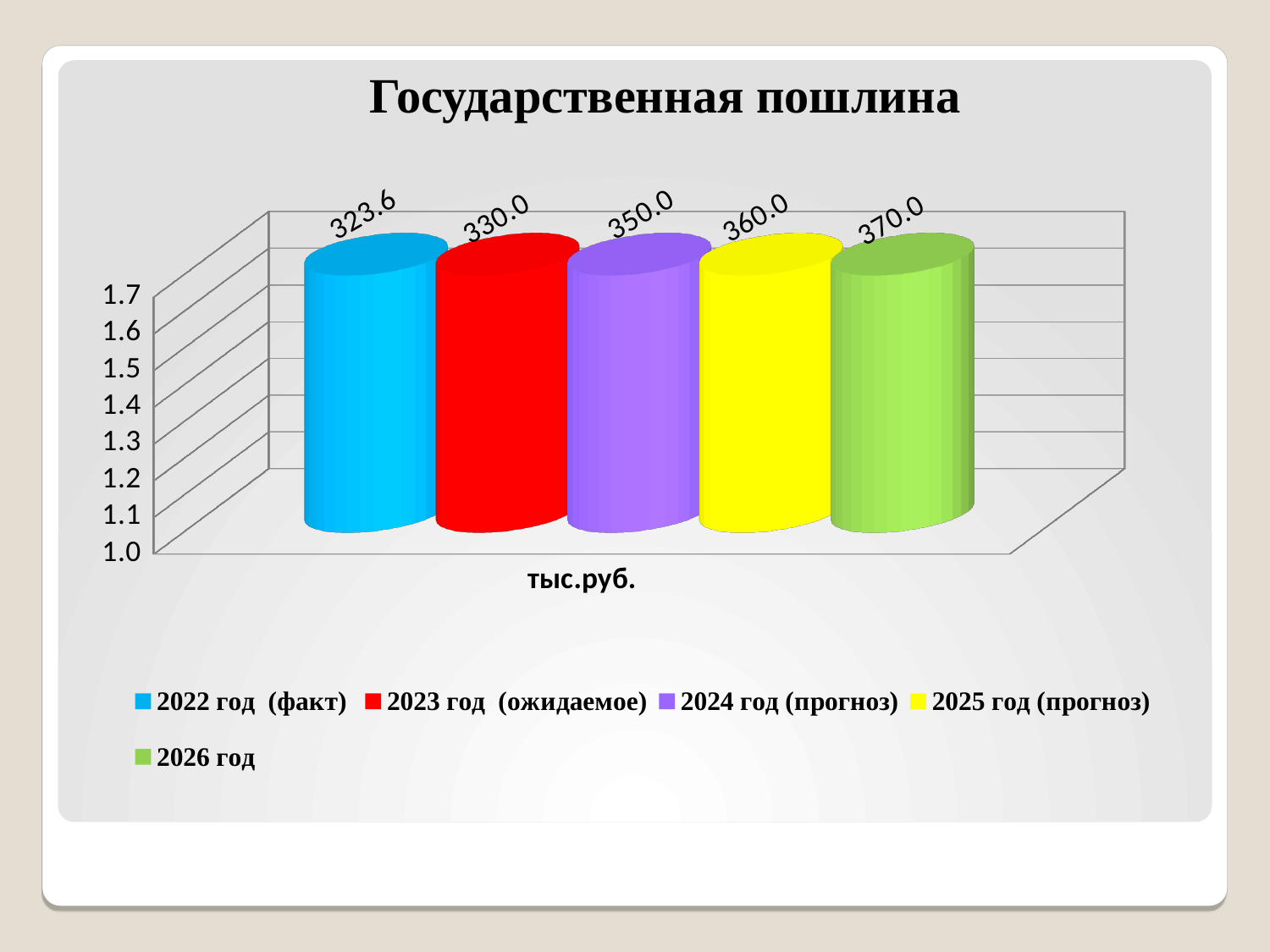
Do the values rise or fall from 2022 to 2026? Rise What is the value for 2024 год (прогноз)? 350.0 What is the difference between the values for 2026 год and 2022 год (факт)? 46.4 What kind of chart is shown? Bar chart Which year has the lowest value? 2022 год (факт) Which is larger, the value for 2024 год (прогноз) or 2023 год (ожидаемое)? 2024 год (прогноз) What is the value for 2022 год (факт)? 323.6 What is the value for 2025 год (прогноз)? 360.0 What is the value for 2026 год? 370.0 How many series does the legend list? 5 Which year has the highest value? 2026 год What is the value for 2023 год (ожидаемое)? 330.0